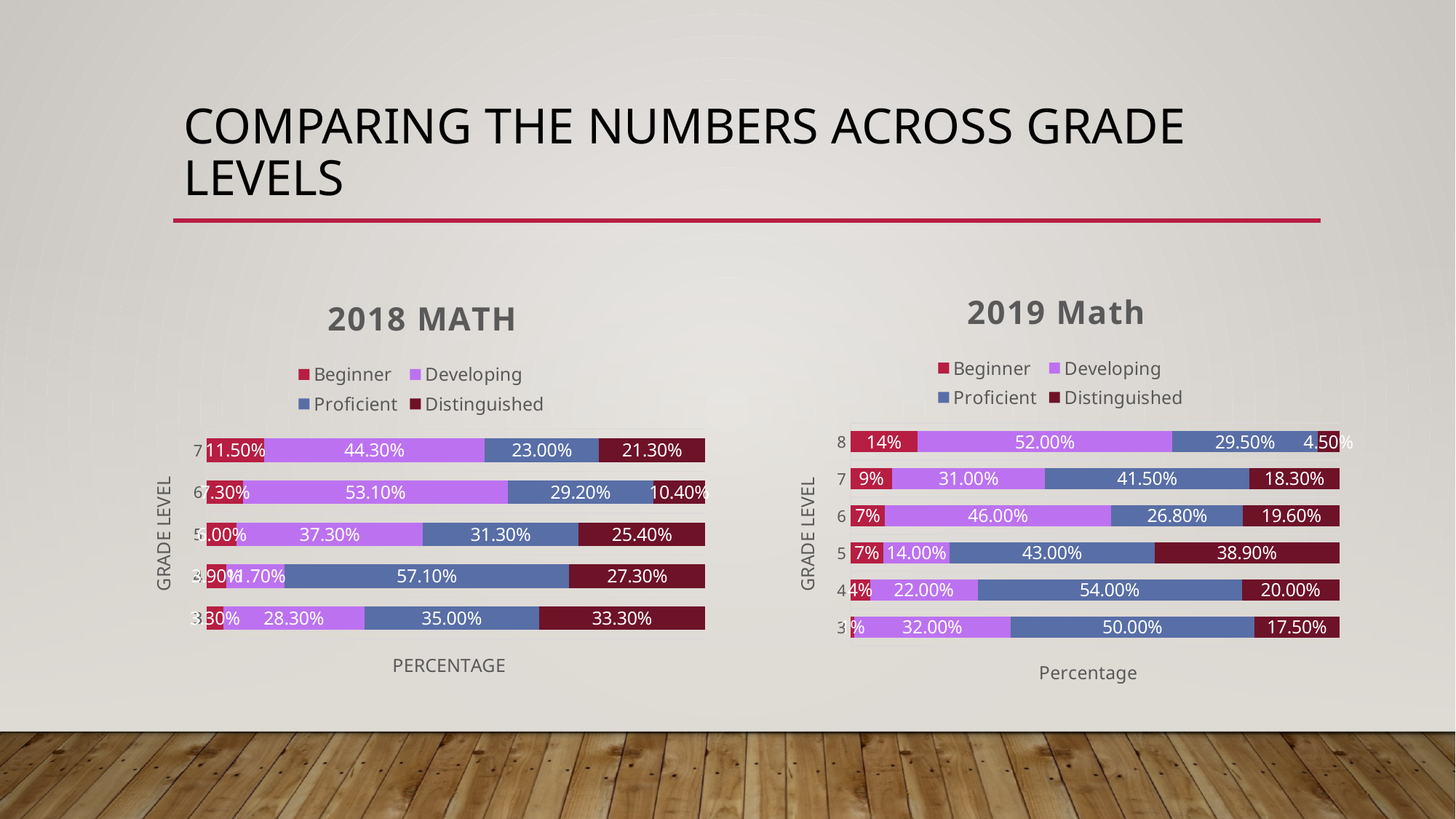
What kind of chart is the 2018 MATH chart? Stacked bar chart How many grade levels are shown in the 2018 MATH chart? 5 In the 2018 MATH chart, what is the Developing value for grade 7? 44.30% In the 2019 Math chart, which grade level has the lowest Distinguished value? 8 In the 2019 Math chart, which is larger, the Proficient value for grade 4 or for grade 7? Grade 4 How many series does the legend of the 2019 Math chart list? 4 In the 2019 Math chart, what is the total of the stacked bar for grade 8? 100% What is the x-axis label of the 2019 Math chart? Percentage In the 2018 MATH chart, which grade level has the highest Distinguished value? 3 In the 2019 Math chart, what is the Distinguished value for grade 5? 38.90% In the 2018 MATH chart, what is the difference between the Distinguished values for grade 5 and grade 6? 15.00% In the 2018 MATH chart, what is the Proficient value for grade 4? 57.10%